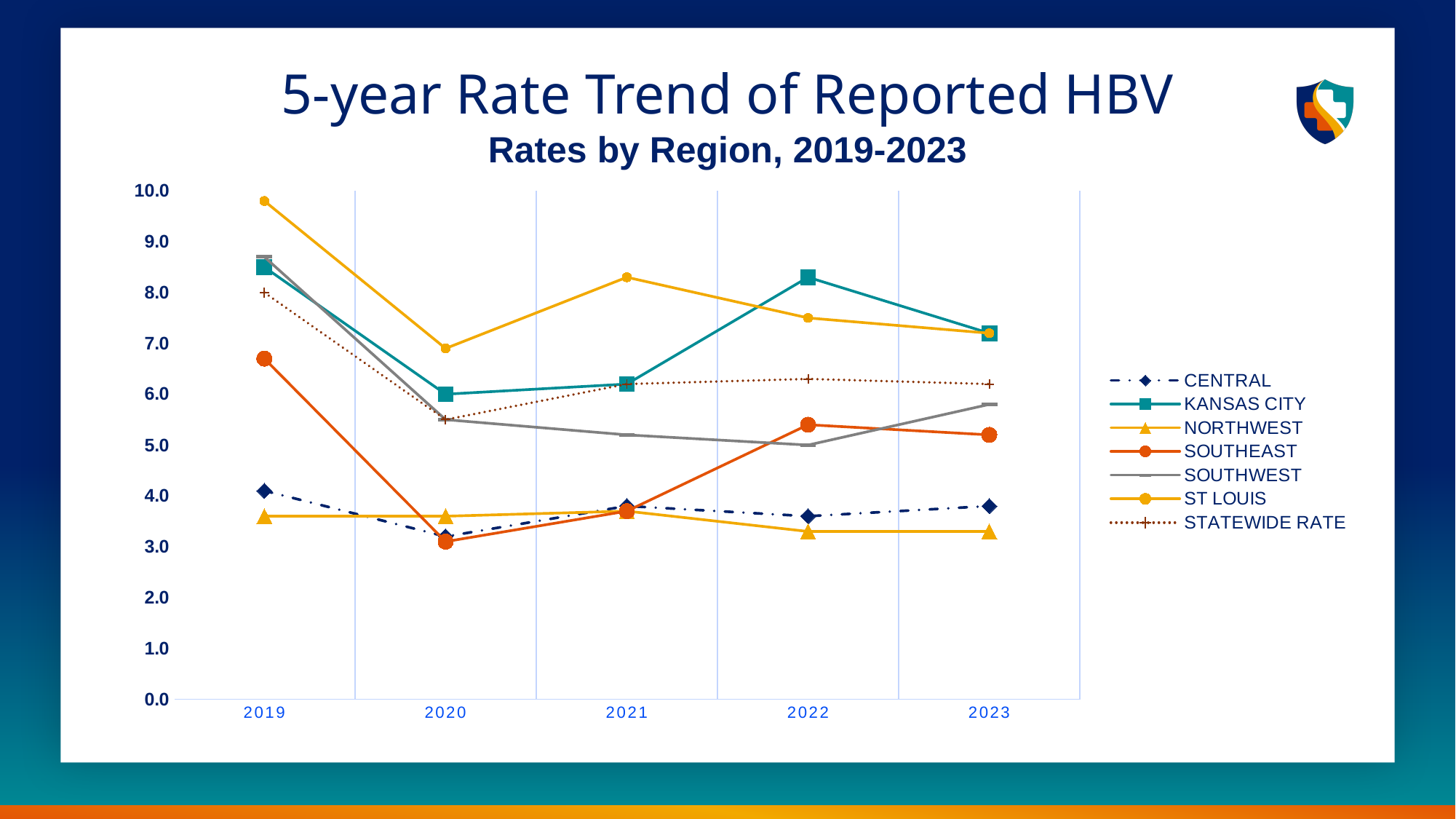
Which region had the lowest rate in 2019? NORTHWEST Does the SOUTHEAST rate rise or fall from 2020 to 2022? rise Is the value for ST LOUIS in 2019 greater or less than 9.0? greater How many series does the legend list? 7 Which region had the highest rate in 2022? KANSAS CITY How many years are shown on the x axis? 5 Is the value for SOUTHEAST in 2020 greater or less than 4.0? less Which region had the lowest rate in 2023? NORTHWEST In 2022, which is larger: the rate for KANSAS CITY or the rate for ST LOUIS? KANSAS CITY What kind of chart is shown on the slide? line chart Is the value for KANSAS CITY in 2021 greater or less than 7.0? less Which region had the highest rate in 2019? ST LOUIS